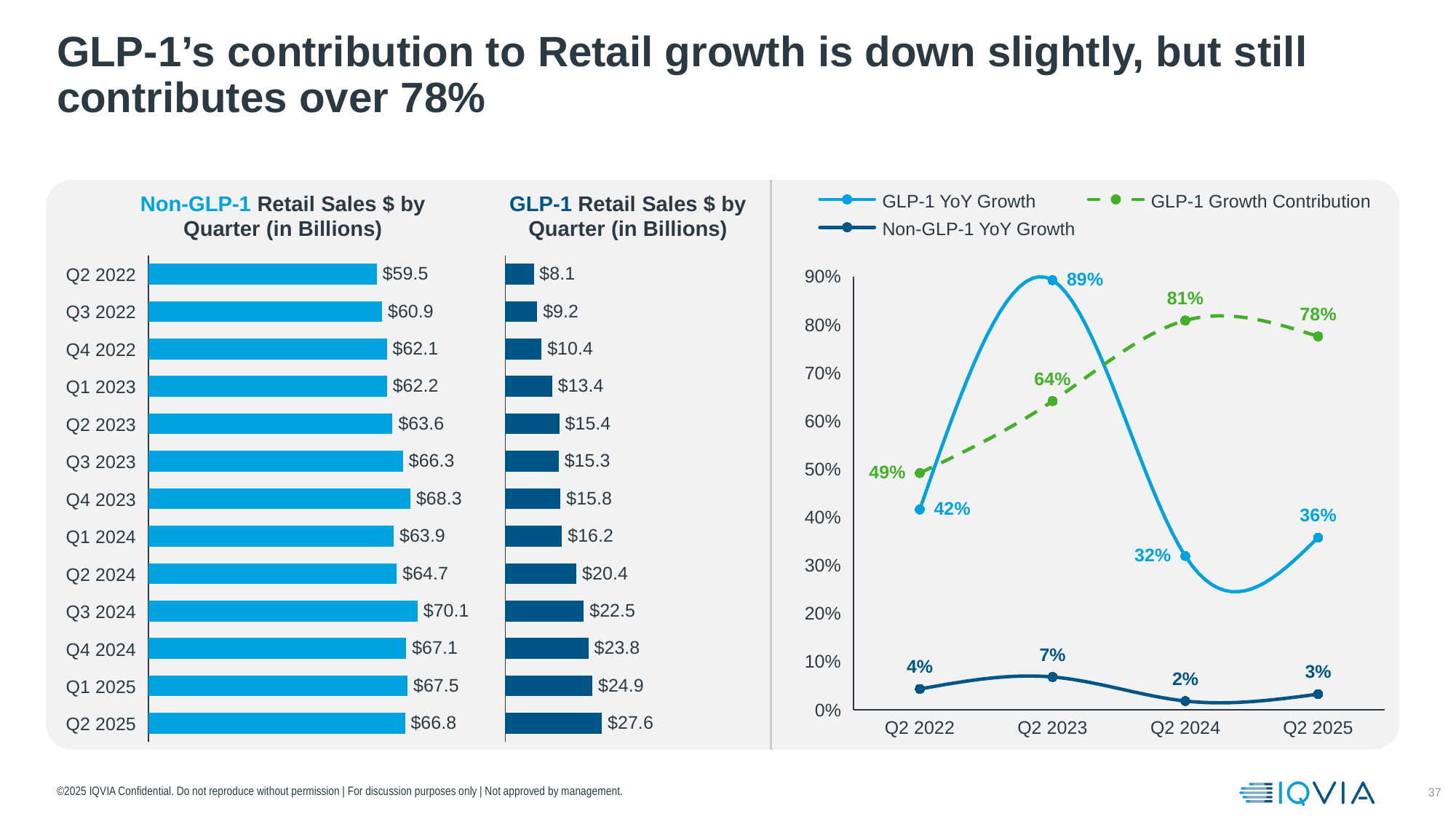
In the GLP-1 Retail Sales $ by Quarter chart, which quarter has the lowest value? Q2 2022 In the Non-GLP-1 Retail Sales $ by Quarter chart, what is the value for Q4 2023? $68.3 In the GLP-1 Retail Sales $ by Quarter chart, what is the difference between Q2 2025 and Q2 2022? $19.5 In the line chart on the right, what is the GLP-1 YoY Growth for Q2 2023? 89% What kind of chart is the Non-GLP-1 Retail Sales $ by Quarter chart? Bar chart In the line chart on the right, what is the GLP-1 Growth Contribution for Q2 2024? 81% How many series does the legend of the line chart on the right list? 3 In the Non-GLP-1 Retail Sales $ by Quarter chart, which is larger, Q2 2024 or Q3 2024? Q3 2024 In the line chart on the right, does the GLP-1 Growth Contribution rise or fall from Q2 2022 to Q2 2024? Rise In the Non-GLP-1 Retail Sales $ by Quarter chart, which quarter has the highest value? Q3 2024 In the GLP-1 Retail Sales $ by Quarter chart, what is the value for Q2 2025? $27.6 How many quarters are shown in the GLP-1 Retail Sales $ by Quarter chart? 13